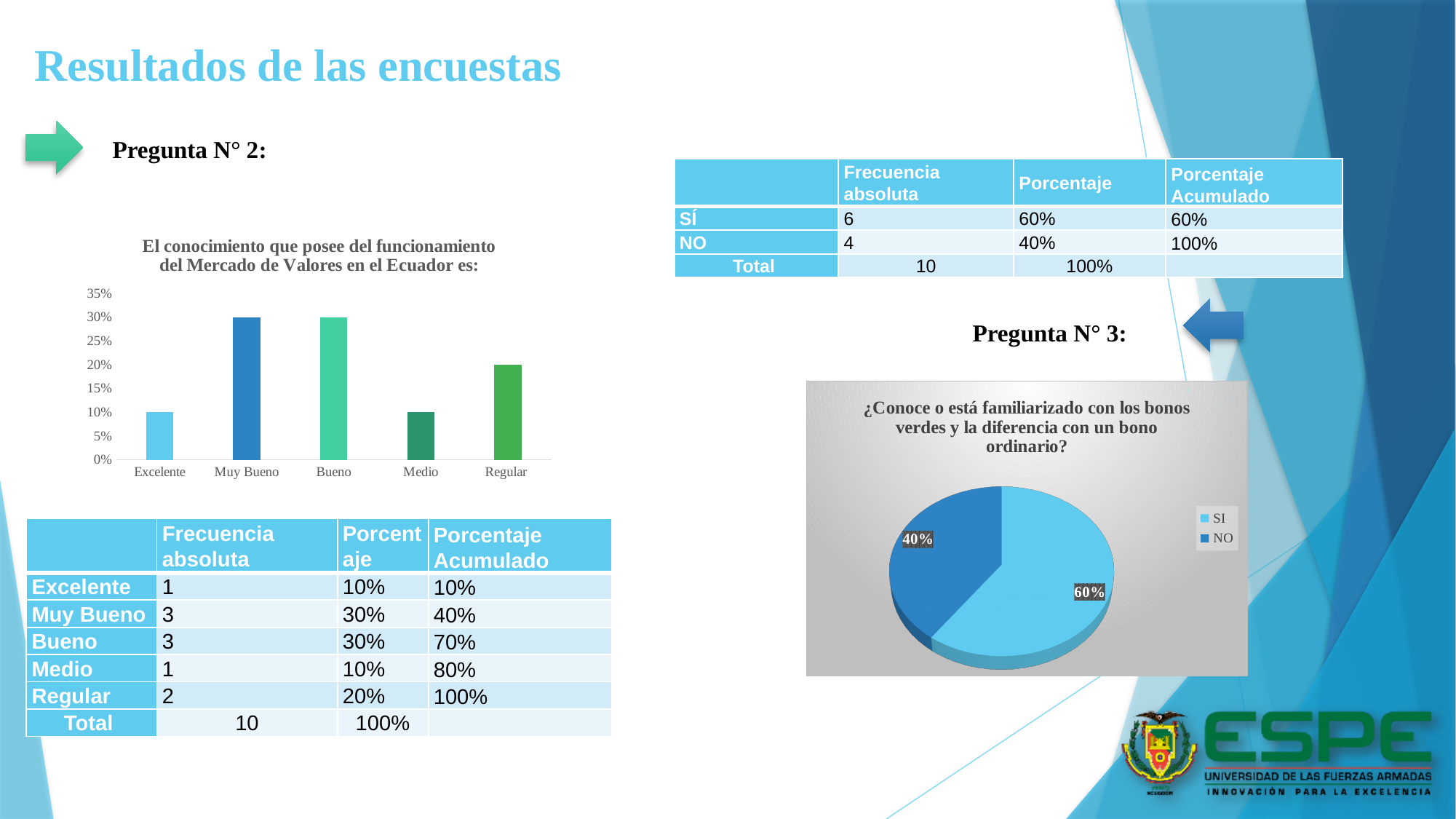
On the bar chart on the left, what is the value for Muy Bueno? 30% On the pie chart under Pregunta N° 3, what share does the SI slice have? 60% On the bar chart on the left, which is larger, the value for Regular or the value for Medio? Regular How many entries does the legend of the pie chart under Pregunta N° 3 list? 2 On the pie chart under Pregunta N° 3, which slice is the largest? SI How many categories are shown on the bar chart on the left? 5 On the bar chart on the left, what is the difference between the value for Bueno and the value for Regular? 10% On the bar chart on the left, what is the value for Regular? 20% On the bar chart on the left, what is the value for Excelente? 10% On the bar chart on the left, is the value for Muy Bueno greater or less than 25%? greater What kind of chart is the chart under Pregunta N° 3? pie chart What kind of chart is the chart on the left of the slide? bar chart